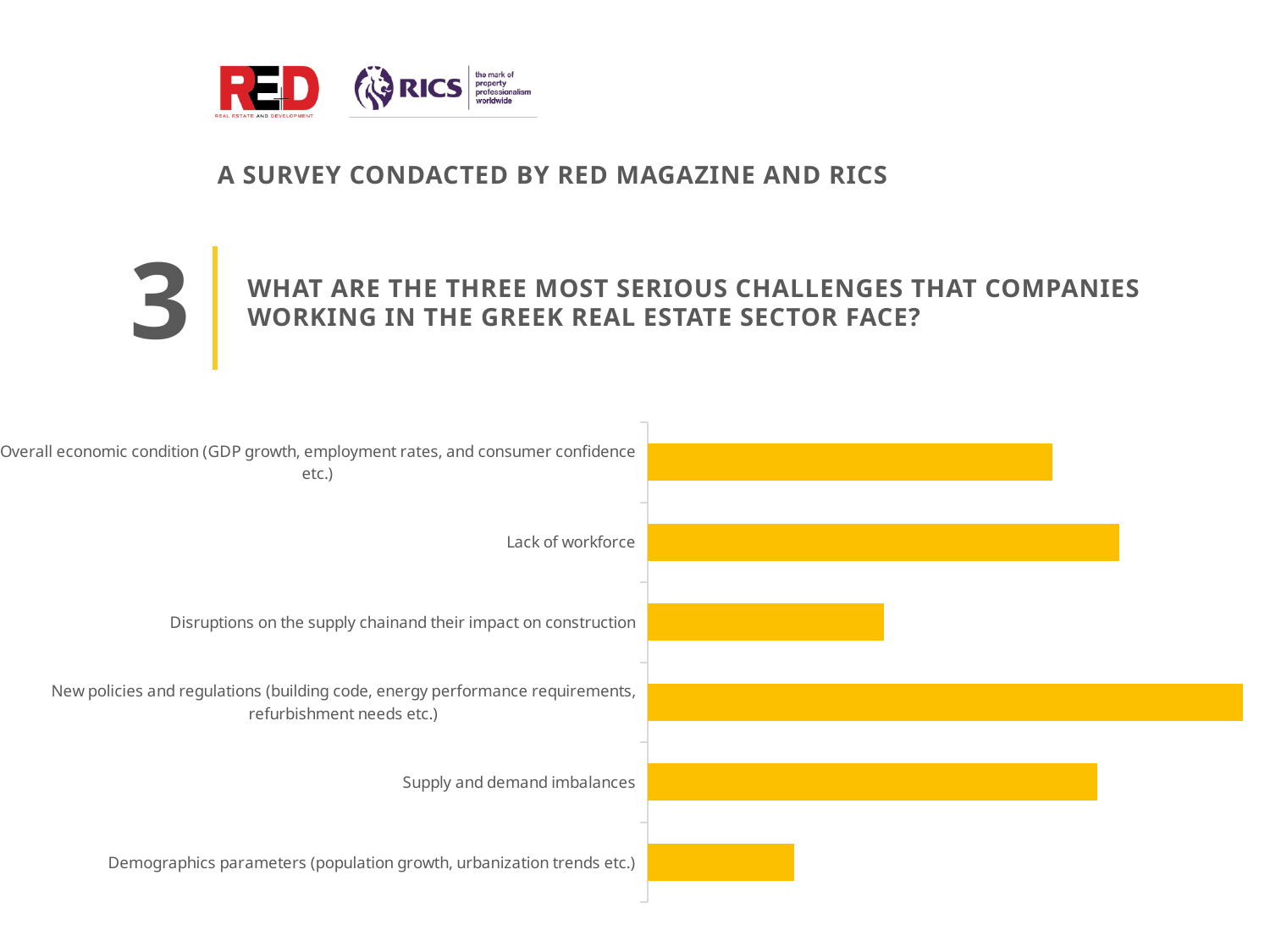
Which bar is longer: Lack of workforce or Overall economic condition? Lack of workforce Which bar is longer: Overall economic condition or Disruptions on the supply chain and their impact on construction? Overall economic condition What survey question does the chart on the slide answer? What are the three most serious challenges that companies working in the Greek real estate sector face? Which challenge has the longest bar in the chart? New policies and regulations (building code, energy performance requirements, refurbishment needs etc.) How many challenge categories are shown in the chart? 6 Which bar is shorter: New policies and regulations or Supply and demand imbalances? Supply and demand imbalances What kind of chart is shown on the slide? Bar chart What colour are the bars in the chart? Yellow Which challenge has the shortest bar in the chart? Demographics parameters (population growth, urbanization trends etc.)